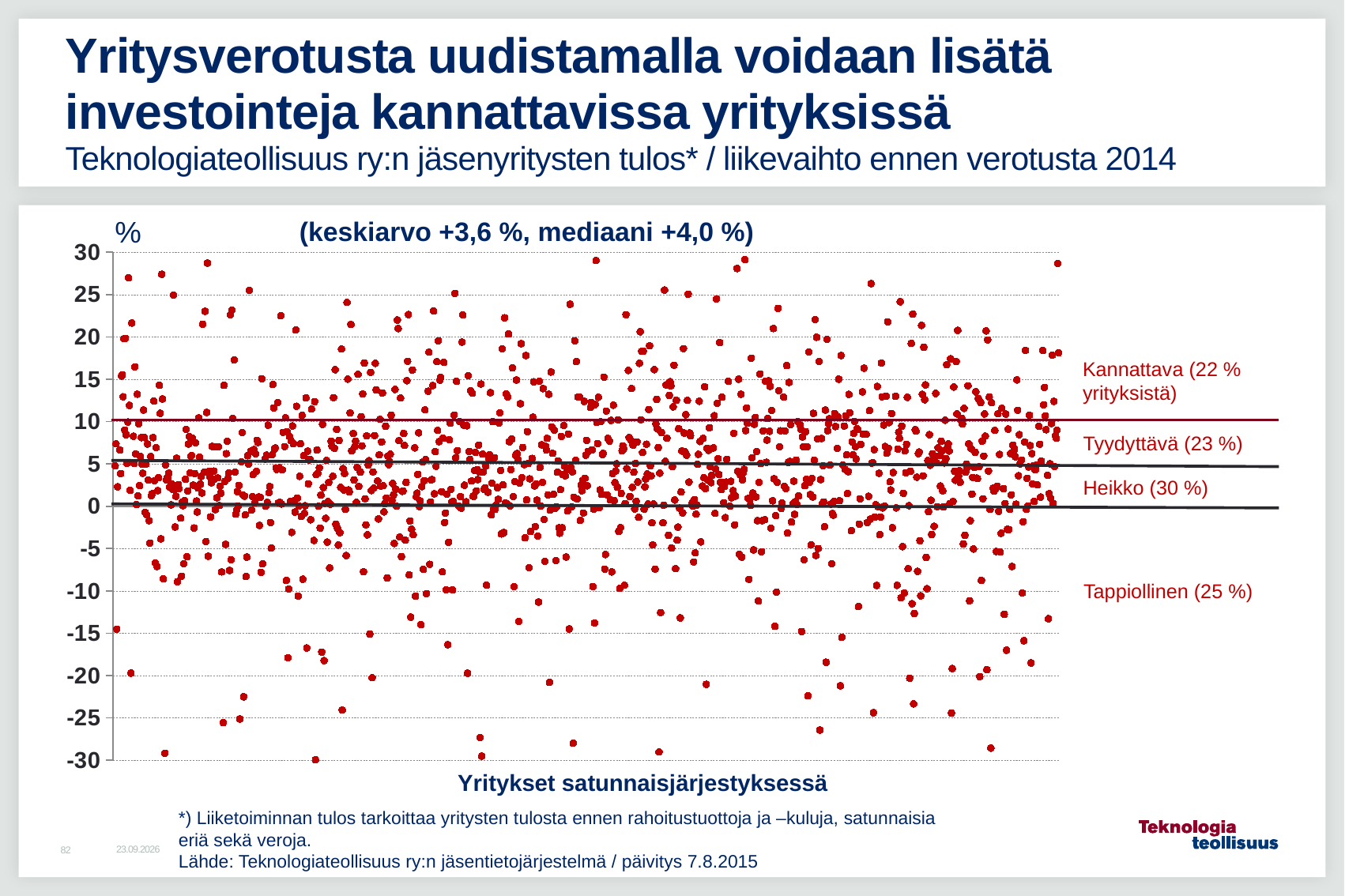
What is the label of the x axis? Yritykset satunnaisjärjestyksessä What is the average (keskiarvo) value stated in the chart heading? +3,6 % What share of companies is labelled Heikko? 30 % Which of the four profitability categories has the largest share of companies? Heikko (30 %) What share of companies is labelled Kannattava? 22 % What share of companies is labelled Tappiollinen? 25 % What share of companies is labelled Tyydyttävä? 23 % What is the median (mediaani) value stated in the chart heading? +4,0 % What kind of chart is shown on the slide? Scatter chart How many profitability categories are labelled on the right side of the chart? 4 How many percentage points larger is the Heikko share than the Tappiollinen share? 5 percentage points Which of the four profitability categories has the smallest share of companies? Kannattava (22 %)